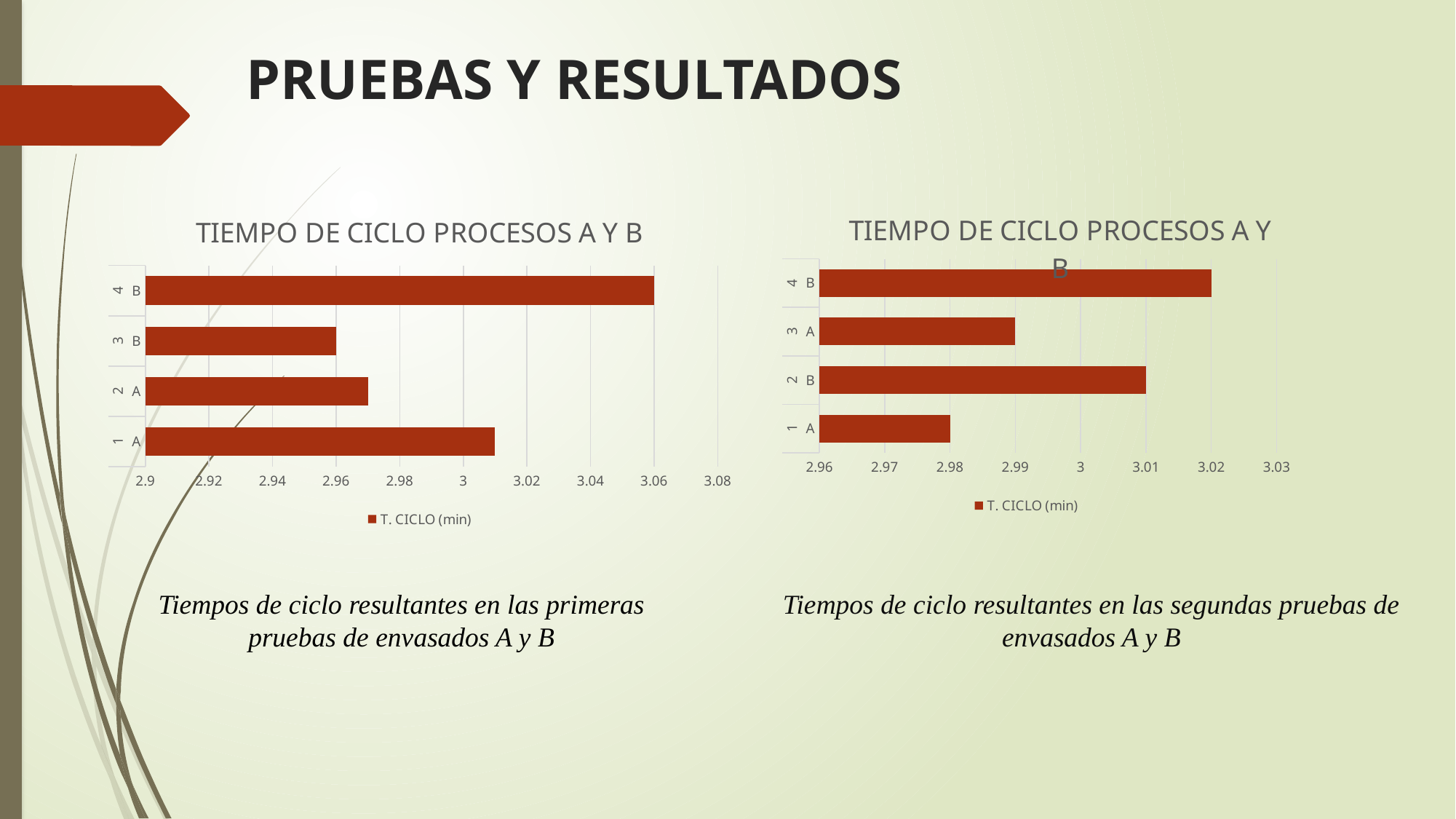
How many bars does the right chart show? 4 In the right chart, what is the value for category 3 A? 2.99 In the left chart, which category has the lowest value? 3 B In the left chart, what is the value for category 4 B? 3.06 What series name does the legend of the left chart show? T. CICLO (min) What kind of chart is the left chart on the slide? bar chart In the right chart, which category has the highest value? 4 B In the right chart, what is the difference between the values for 4 B and 1 A? 0.04 In the right chart, which is larger, the value for 2 B or the value for 3 A? 2 B In the left chart, is the value for category 2 A greater or less than 2.98? less In the right chart, what is the value for category 1 A? 2.98 In the right chart, what is the value for category 4 B? 3.02